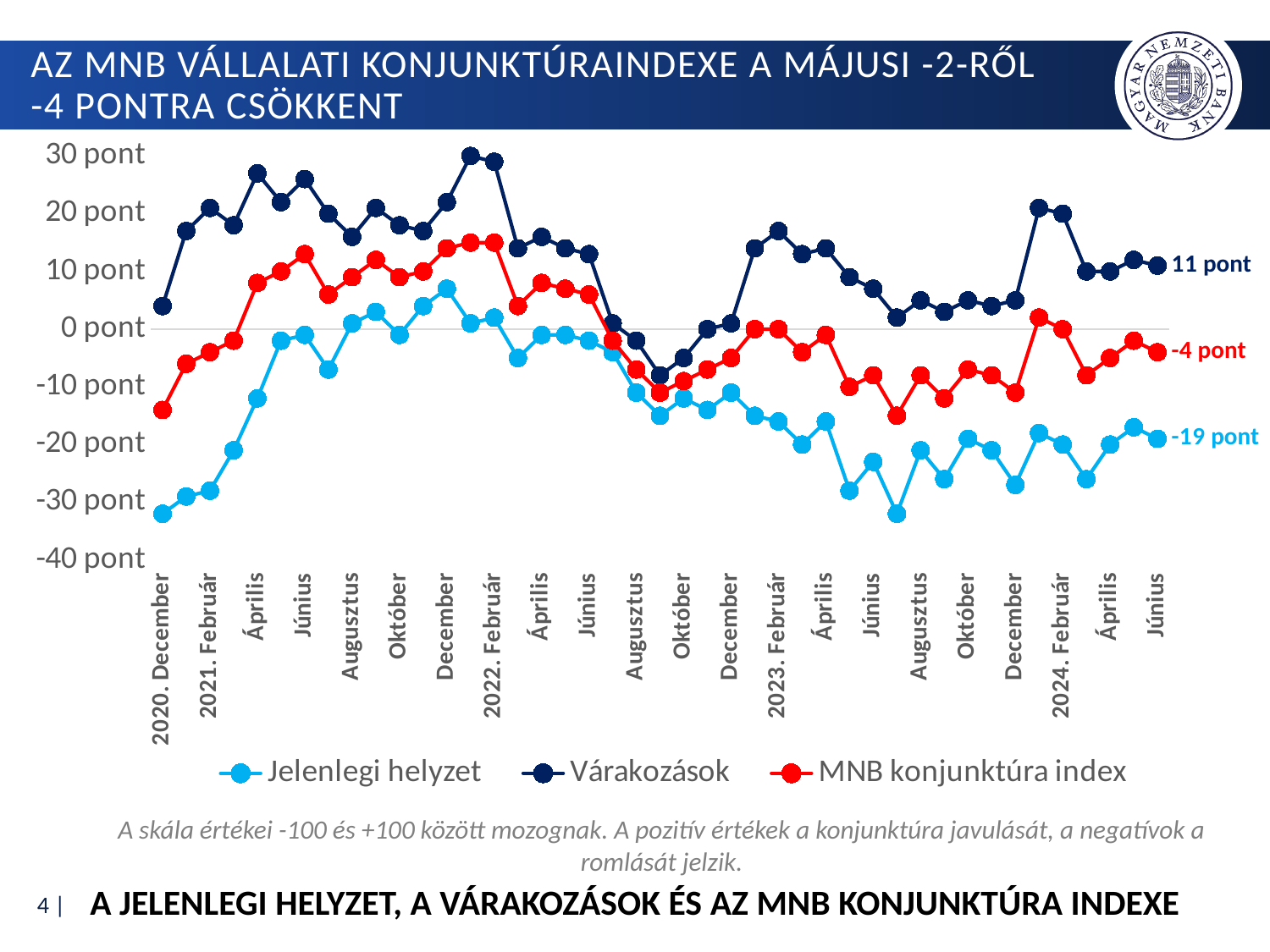
What kind of chart is shown on the slide? Line chart Which series is drawn in red in the legend? MNB konjunktúra index Is the value of the Várakozások series in 2020 December greater or less than 0 pont? greater At the last point, what is the difference between the Várakozások value and the Jelenlegi helyzet value? 30 pont At the last point, what is the difference between the Várakozások value and the MNB konjunktúra index value? 15 pont Does the Jelenlegi helyzet series rise or fall between 2020 December and 2021 Június? rise How many series does the legend list? 3 What is the value of the Jelenlegi helyzet series at the last point (2024 Június)? -19 pont What is the value of the Várakozások series at the last point (2024 Június)? 11 pont Which series has the highest value at the last point of the chart? Várakozások What is the value of the MNB konjunktúra index at the last point (2024 Június)? -4 pont At 2024 Június, which series has the higher value: Jelenlegi helyzet or MNB konjunktúra index? MNB konjunktúra index